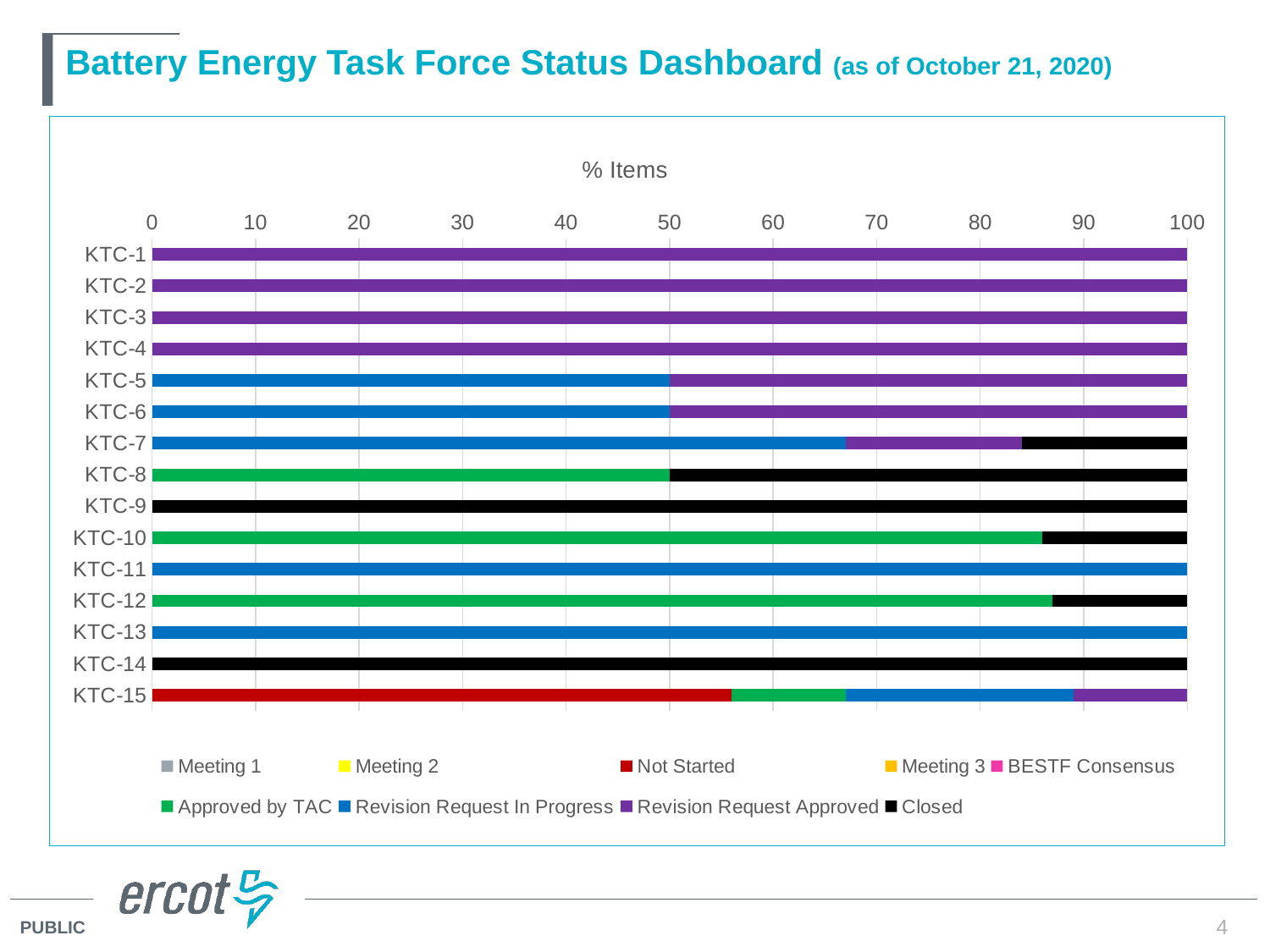
What is the title of the chart? % Items What is the Closed value for KTC-8? 50 Is the Revision Request In Progress value for KTC-7 greater or less than 60? greater Is the Not Started value for KTC-15 greater or less than 50? greater What is the Approved by TAC value for KTC-8? 50 What is the total of the stacked bar for KTC-1? 100 Which colour represents the Closed series in the legend? Black What is the Revision Request In Progress value for KTC-5? 50 Is the Approved by TAC value for KTC-10 greater or less than 80? greater How many KTC categories are plotted on the chart? 15 How many series does the legend list? 9 What kind of chart is shown on the slide? Stacked bar chart